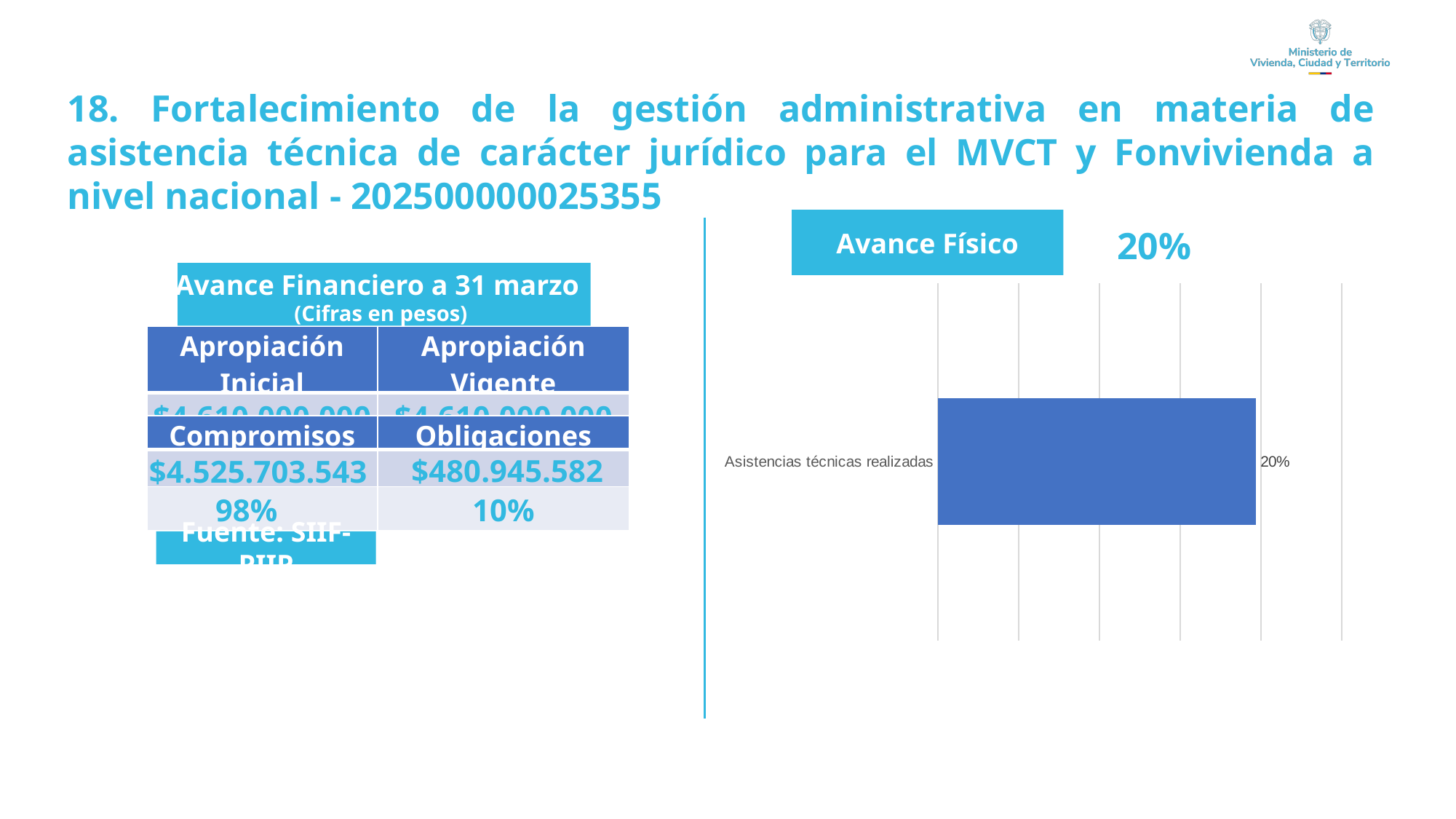
What kind of chart is shown on the slide? bar chart How many categories are plotted in the chart? 1 What is the title of the chart on the right side of the slide? Avance Físico What is the label of the single category plotted in the chart? Asistencias técnicas realizadas What is the value shown for "Asistencias técnicas realizadas" in the chart? 20%